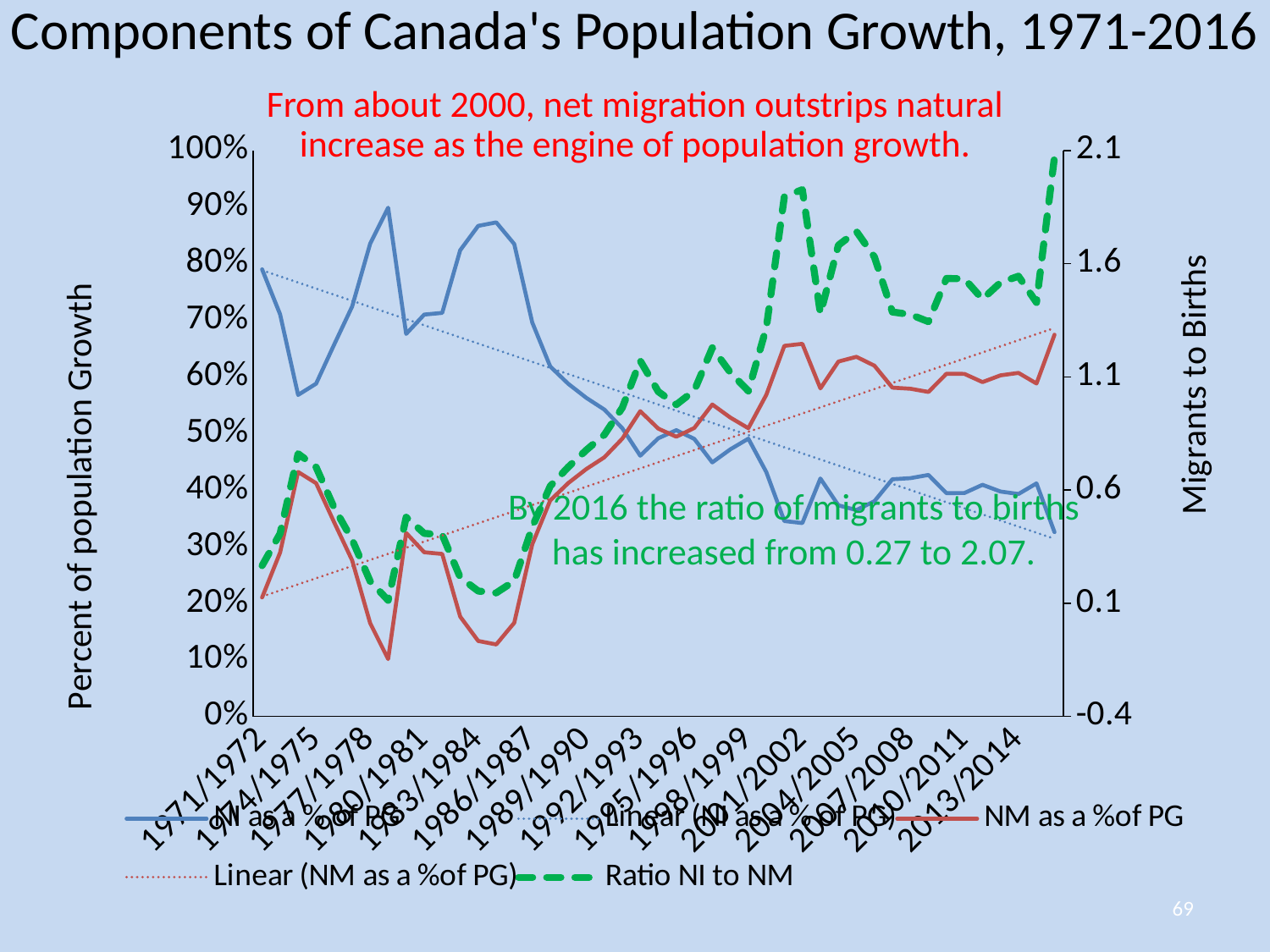
How many series does the legend list? 5 Does the 'NI as a % of PG' series generally rise or fall from 1971/1972 to the end of the period? fall In 1971/1972, which is larger: 'NI as a % of PG' or 'NM as a % of PG'? NI as a % of PG Is the value of 'NI as a % of PG' in 1983/1984 greater or less than 80%? greater In 2013/2014, which is larger: 'NI as a % of PG' or 'NM as a % of PG'? NM as a % of PG Is the value of 'NI as a % of PG' in 1971/1972 greater or less than 70%? greater Does the 'NM as a % of PG' series generally rise or fall across the period? rise What is the label of the right-hand vertical axis? Migrants to Births What is the title of the chart? Components of Canada's Population Growth, 1971-2016 What kind of chart is shown on the slide? line chart Is the value of 'Ratio NI to NM' in 2001/2002 greater or less than 1.6? greater Does the 'Ratio NI to NM' series generally rise or fall across the period? rise